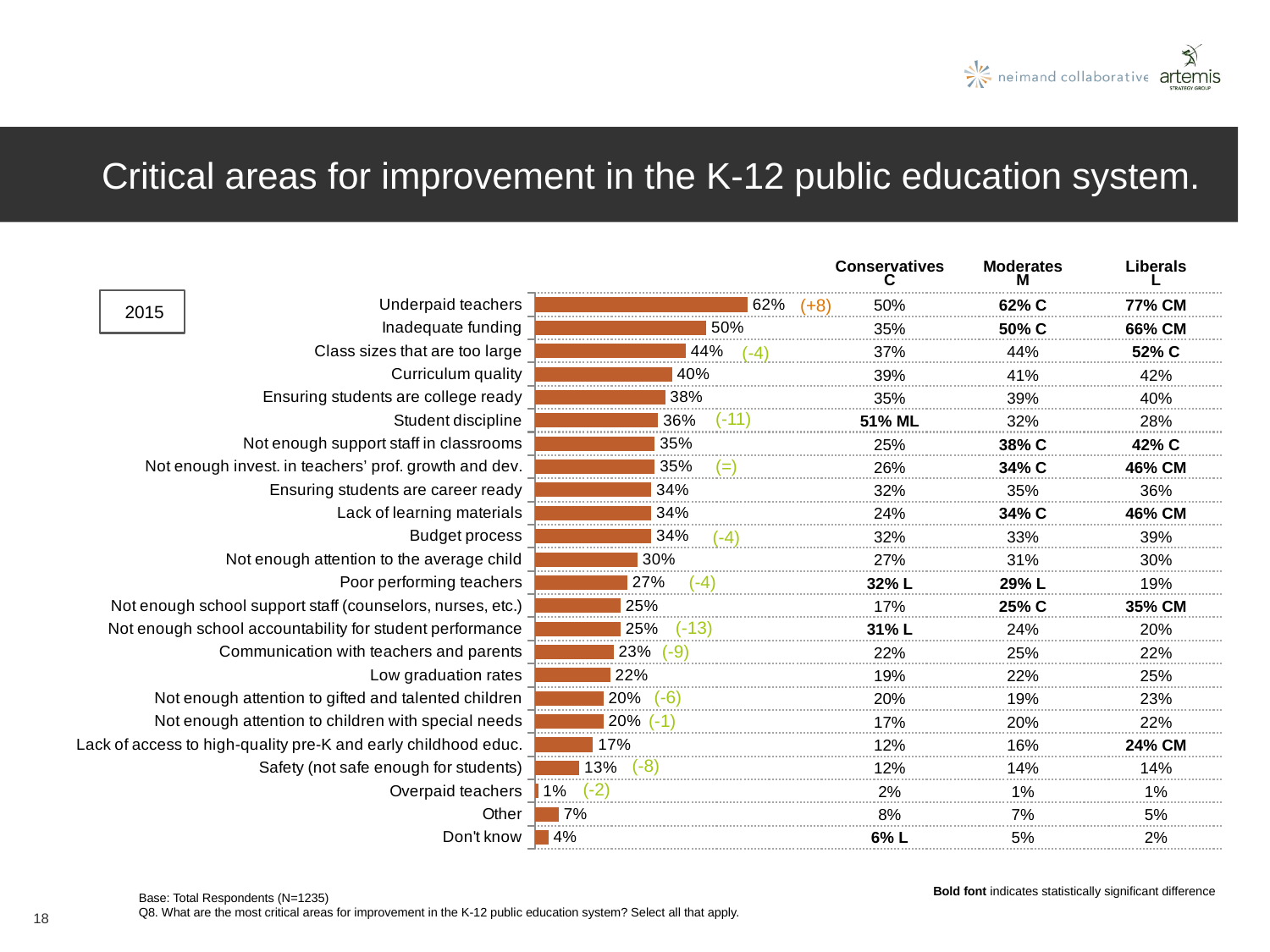
Which category has the lowest value in the bar chart? Overpaid teachers What kind of chart is shown on the slide? Bar chart What is the value for Underpaid teachers in the bar chart? 62% What is the difference between the values for Class sizes that are too large and Curriculum quality? 4% How many categories are plotted in the bar chart? 24 What is the difference between the values for Underpaid teachers and Inadequate funding? 12% What is the value for Safety (not safe enough for students) in the bar chart? 13% Which category has the highest value in the bar chart? Underpaid teachers What is the title of the slide containing the chart? Critical areas for improvement in the K-12 public education system. Which is larger: the value for Other or the value for Don't know? Other What is the value for Inadequate funding in the bar chart? 50% Which is larger: the value for Student discipline or the value for Low graduation rates? Student discipline